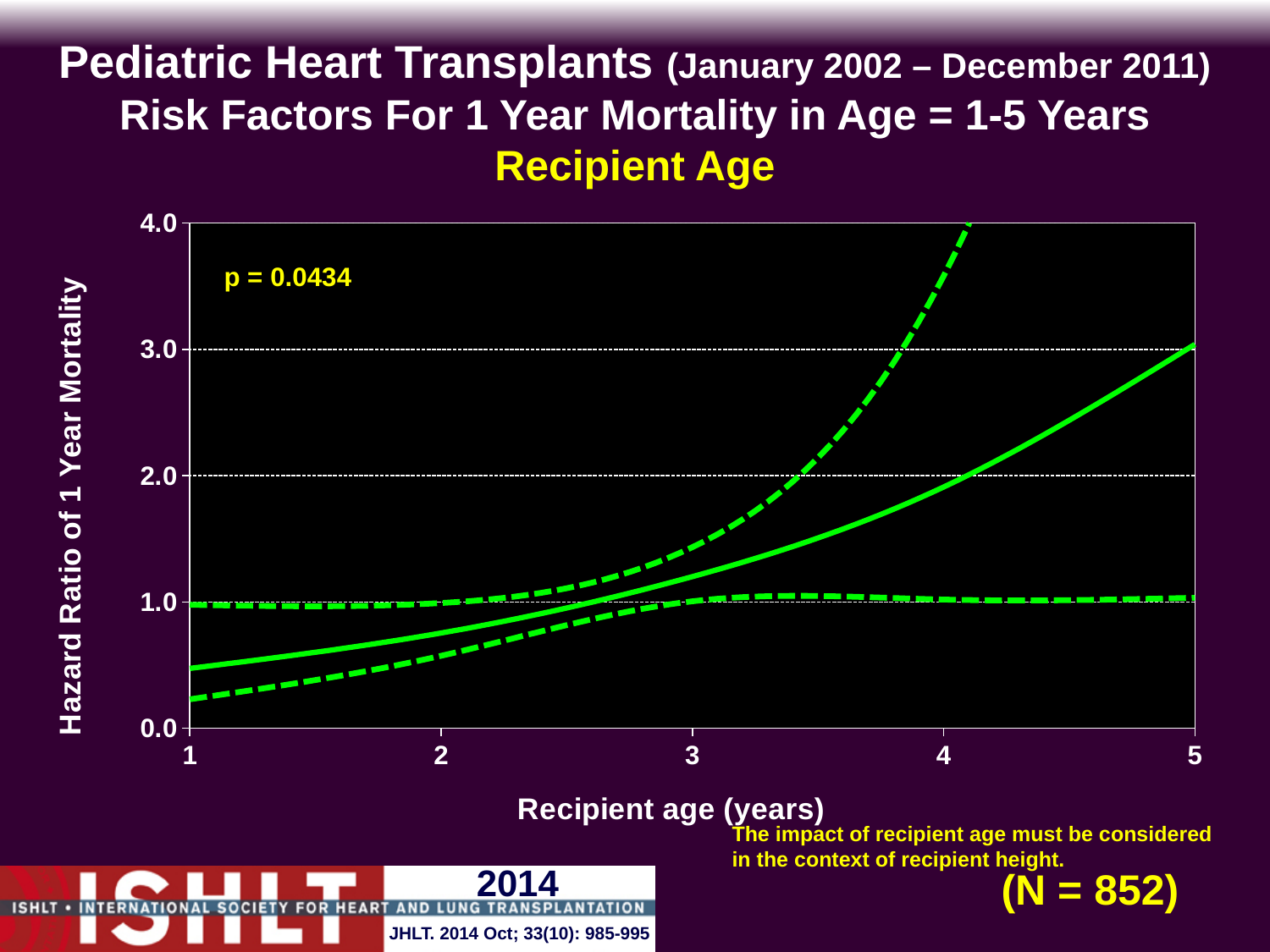
Does the solid hazard ratio line rise or fall as recipient age increases from 1 to 5 years? rises Is the lower dashed line at recipient age 1 year greater or less than 1.0? less Is the upper dashed line at recipient age 4 years greater or less than 3.0? greater How many tick marks are labelled on the x axis? 5 Is the hazard ratio on the solid line at recipient age 3 years greater or less than 1.0? greater What is the label of the y axis? Hazard Ratio of 1 Year Mortality What p-value is printed on the chart? p = 0.0434 What kind of chart is shown on the slide? line chart Is the solid line's hazard ratio higher at recipient age 5 years or at recipient age 1 year? 5 years